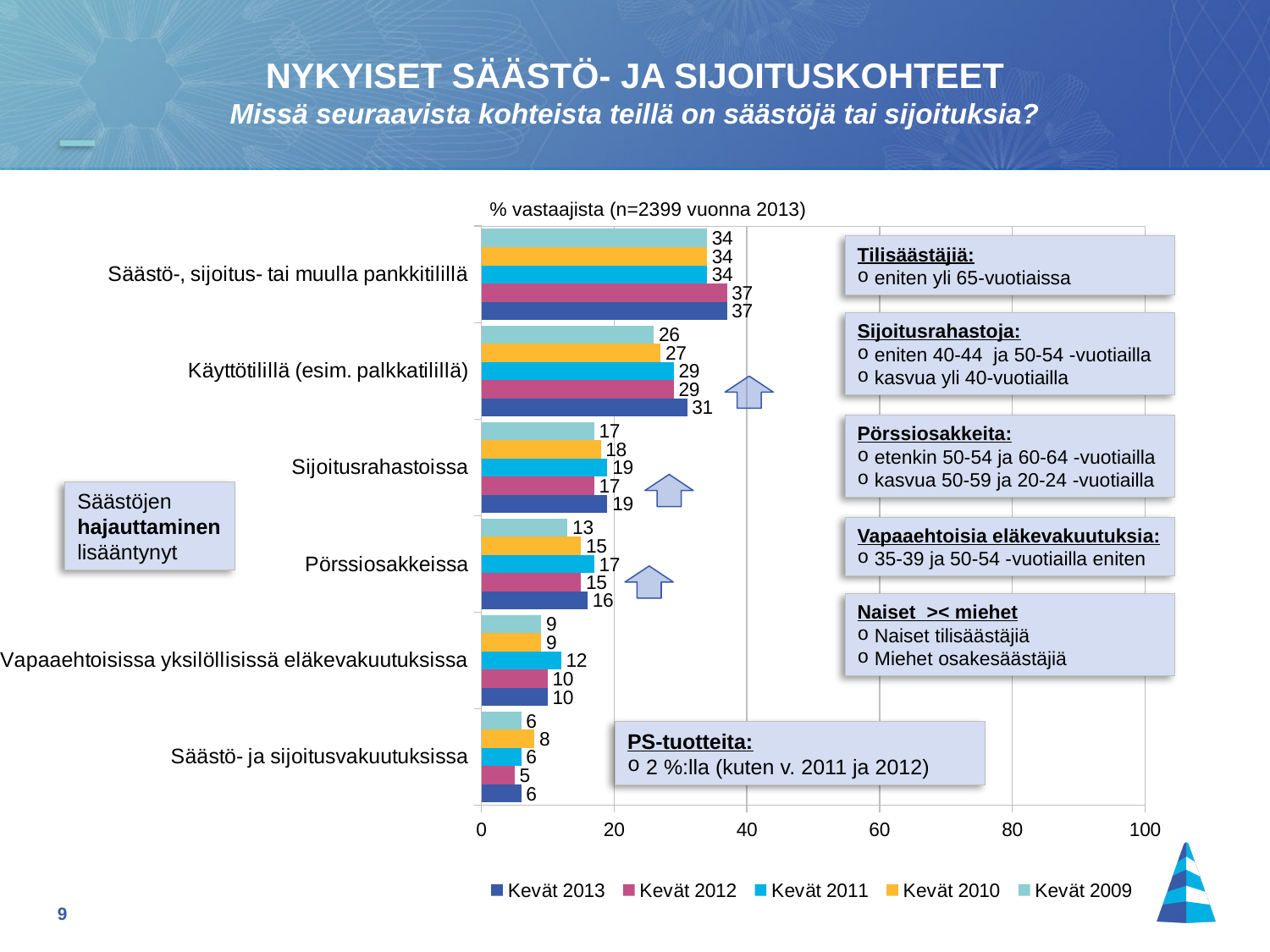
What is the Kevät 2011 value for Pörssiosakkeissa? 17 How many categories are shown on the chart? 6 How many series does the legend list? 5 Which category has the highest Kevät 2013 value? Säästö-, sijoitus- tai muulla pankkitilillä Which is larger for Vapaaehtoisissa yksilöllisissä eläkevakuutuksissa: the Kevät 2011 value or the Kevät 2013 value? Kevät 2011 What is the axis label shown above the chart? % vastaajista (n=2399 vuonna 2013) What is the Kevät 2009 value for Käyttötilillä (esim. palkkatilillä)? 26 What is the difference between the Kevät 2013 and Kevät 2009 values for Käyttötilillä (esim. palkkatilillä)? 5 Which category has the lowest Kevät 2012 value? Säästö- ja sijoitusvakuutuksissa What kind of chart is shown on the slide? bar chart What is the Kevät 2013 value for Säästö-, sijoitus- tai muulla pankkitilillä? 37 Is the Kevät 2013 value for Sijoitusrahastoissa greater or less than 20? less